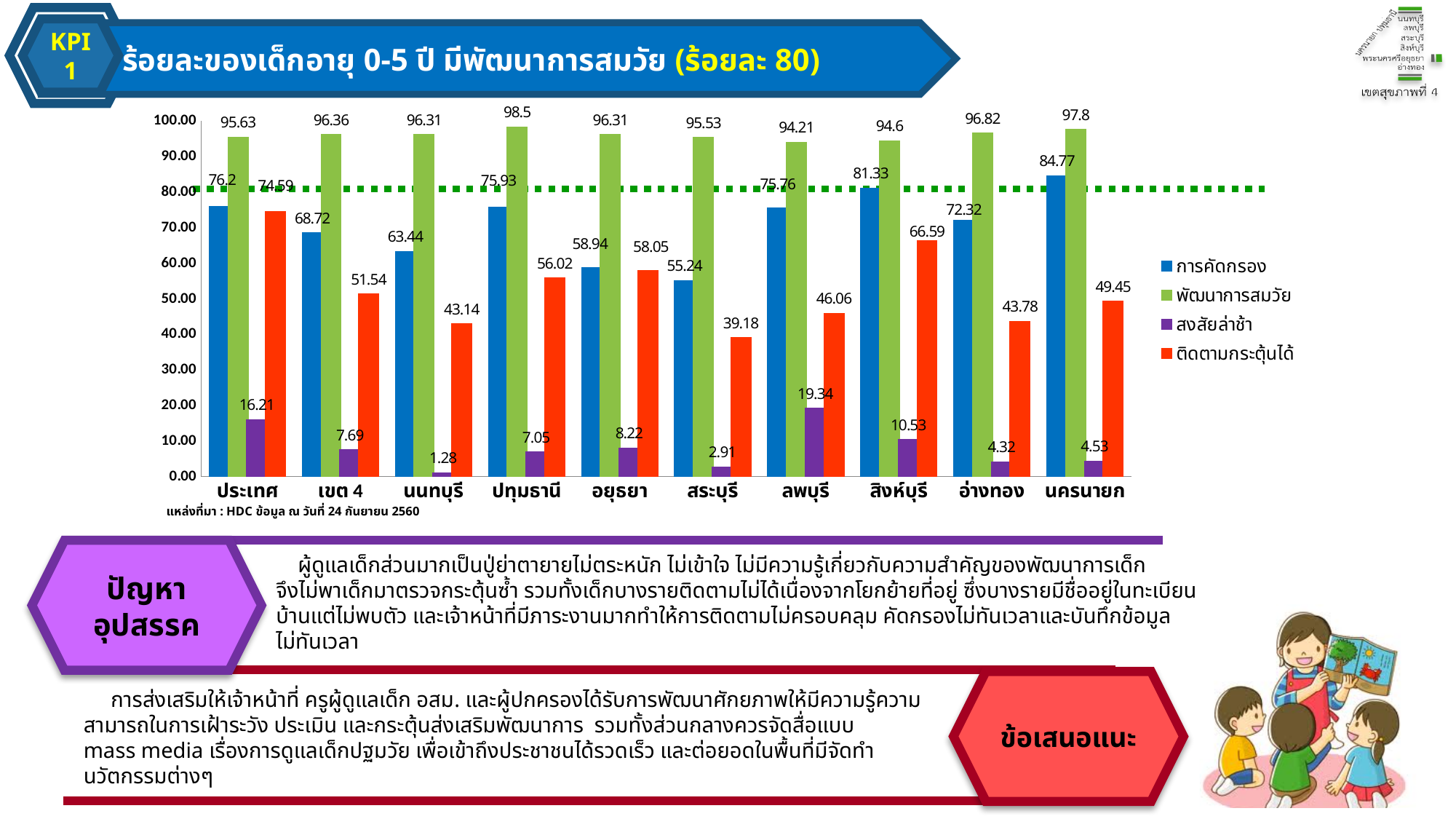
What kind of chart is shown on the slide? bar chart Which category has the lowest value for การคัดกรอง? สระบุรี Which category has the lowest value for สงสัยล่าช้า? นนทบุรี How many categories are shown on the x axis? 10 What is the value of พัฒนาการสมวัย for ปทุมธานี? 98.5 What is the difference between the การคัดกรอง values for นครนายก and สิงห์บุรี? 3.44 Which category has the highest value for พัฒนาการสมวัย? ปทุมธานี Which is larger, the ติดตามกระตุ้นได้ value for ประเทศ or for เขต 4? ประเทศ How many series does the legend list? 4 What is the value of การคัดกรอง for นครนายก? 84.77 What is the value of ติดตามกระตุ้นได้ for สิงห์บุรี? 66.59 What is the value of สงสัยล่าช้า for ลพบุรี? 19.34